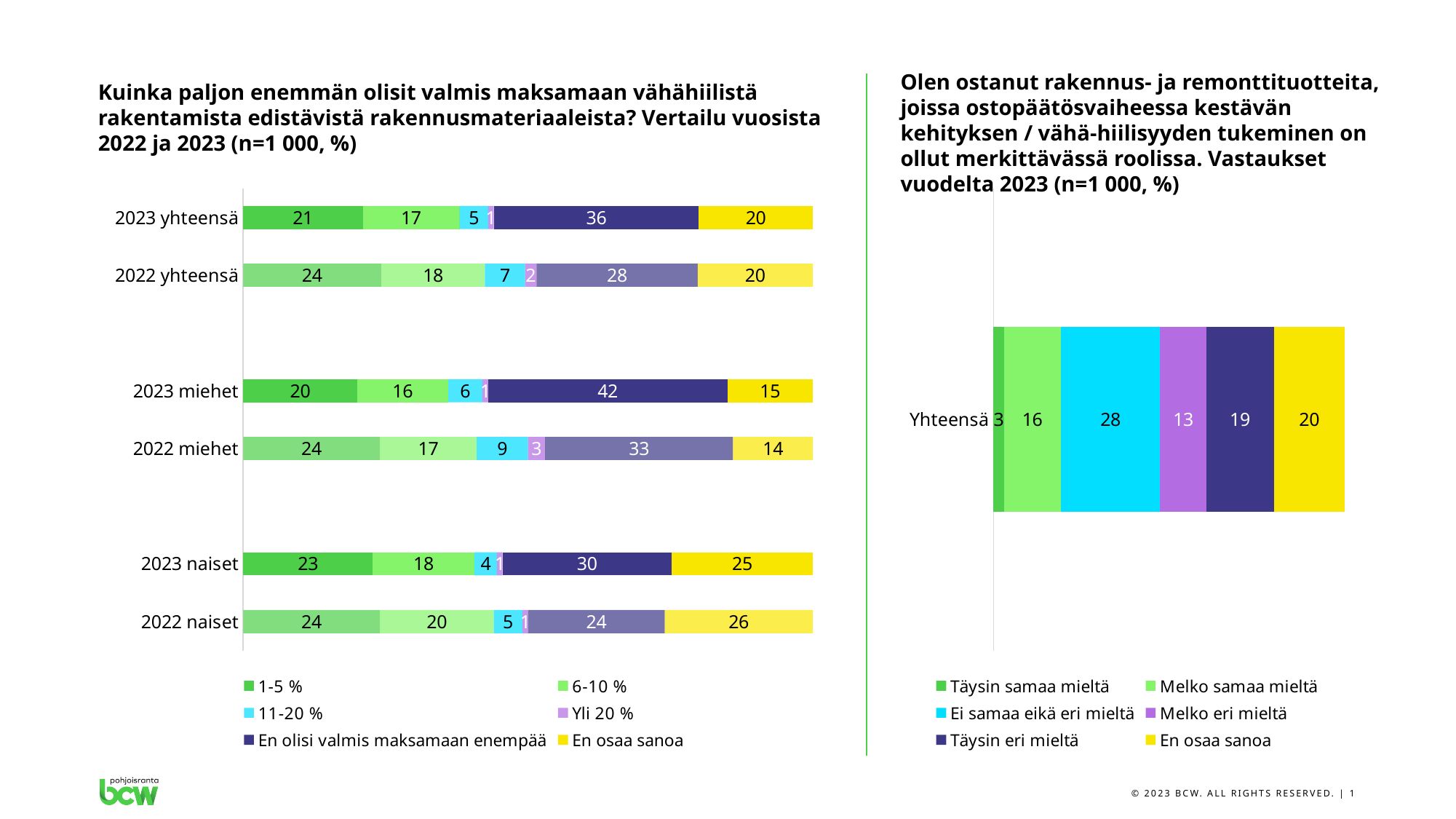
What kind of chart is the left chart? Stacked bar chart In the left chart, what is the value of '11-20 %' for 2022 miehet? 9 In the left chart (Kuinka paljon enemmän olisit valmis maksamaan...), what is the value of 'En olisi valmis maksamaan enempää' for 2023 miehet? 42 In the left chart, what is the difference between the 'En olisi valmis maksamaan enempää' values for 2023 yhteensä and 2022 yhteensä? 8 In the left chart, which category has the highest value for 'En olisi valmis maksamaan enempää'? 2023 miehet In the right chart, what is the total of all segments in the Yhteensä bar? 99 In the right chart (Olen ostanut rakennus- ja remonttituotteita...), what is the value for 'Ei samaa eikä eri mieltä'? 28 In the right chart, which response has the smallest value? Täysin samaa mieltä How many series does the legend of the left chart list? 6 In the left chart, which is larger for '1-5 %': 2023 naiset or 2023 miehet? 2023 naiset How many categories (bars) does the left chart show? 6 In the left chart, what is the value of 'En osaa sanoa' for 2022 naiset? 26